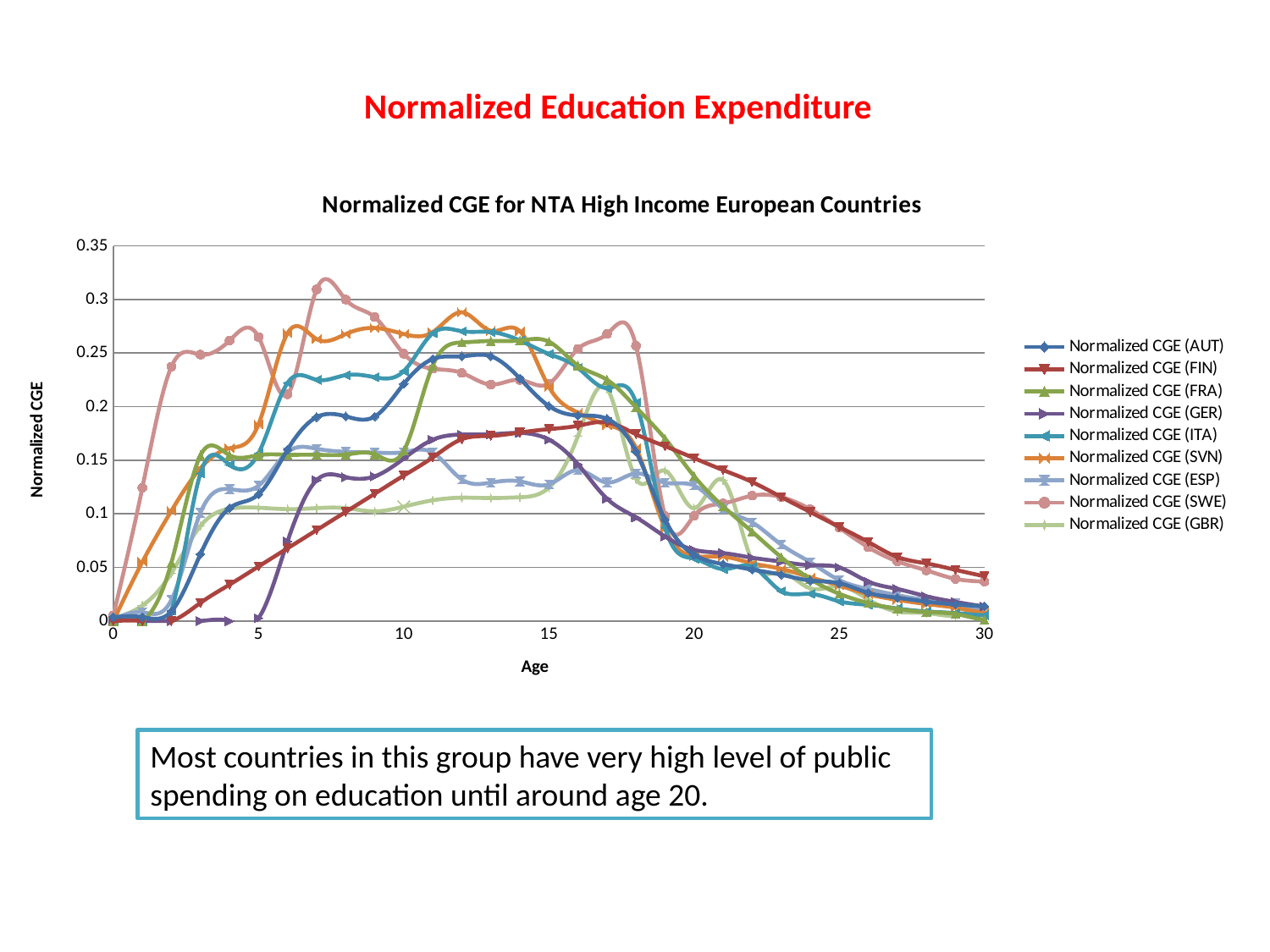
Which series reaches the highest value anywhere on the chart? Normalized CGE (SWE) Is the value for Normalized CGE (GER) at age 4 greater or less than 0.05? less Does the Normalized CGE (FIN) series rise or fall between age 20 and age 30? fall What is the title of the chart? Normalized CGE for NTA High Income European Countries Is the value for Normalized CGE (GBR) at age 10 greater or less than 0.15? less Is the value for Normalized CGE (SVN) at age 12 greater or less than 0.25? greater At age 12, which is larger: Normalized CGE (SVN) or Normalized CGE (GBR)? Normalized CGE (SVN) How many series does the legend list? 9 What kind of chart is shown on the slide? line chart What is the label of the vertical axis? Normalized CGE